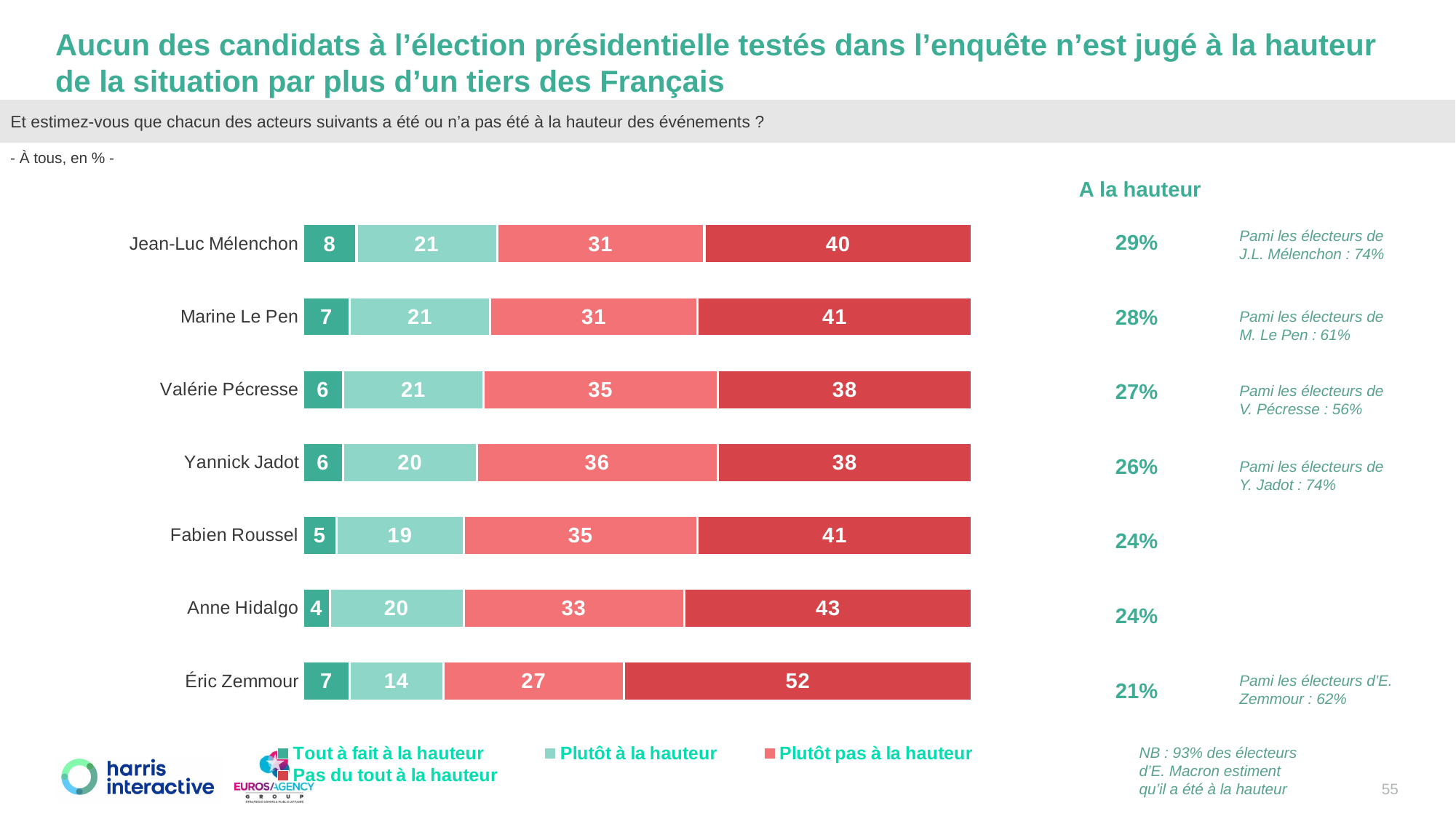
What is the value of "Tout à fait à la hauteur" for Jean-Luc Mélenchon? 8 What kind of chart is shown on the slide? Stacked bar chart Which is larger: the "Plutôt à la hauteur" value for Fabien Roussel or for Éric Zemmour? Fabien Roussel What is the value of "Plutôt pas à la hauteur" for Yannick Jadot? 36 How many candidates are shown in the chart? 7 What is the value of "Pas du tout à la hauteur" for Éric Zemmour? 52 What is the "A la hauteur" percentage shown for Valérie Pécresse? 27% What is the total of "Tout à fait à la hauteur" and "Plutôt à la hauteur" for Marine Le Pen? 28 Which candidate has the highest "Pas du tout à la hauteur" value? Éric Zemmour What is the difference between the "Pas du tout à la hauteur" values for Éric Zemmour and Jean-Luc Mélenchon? 12 How many series does the legend list? 4 Which candidate has the lowest "Tout à fait à la hauteur" value? Anne Hidalgo